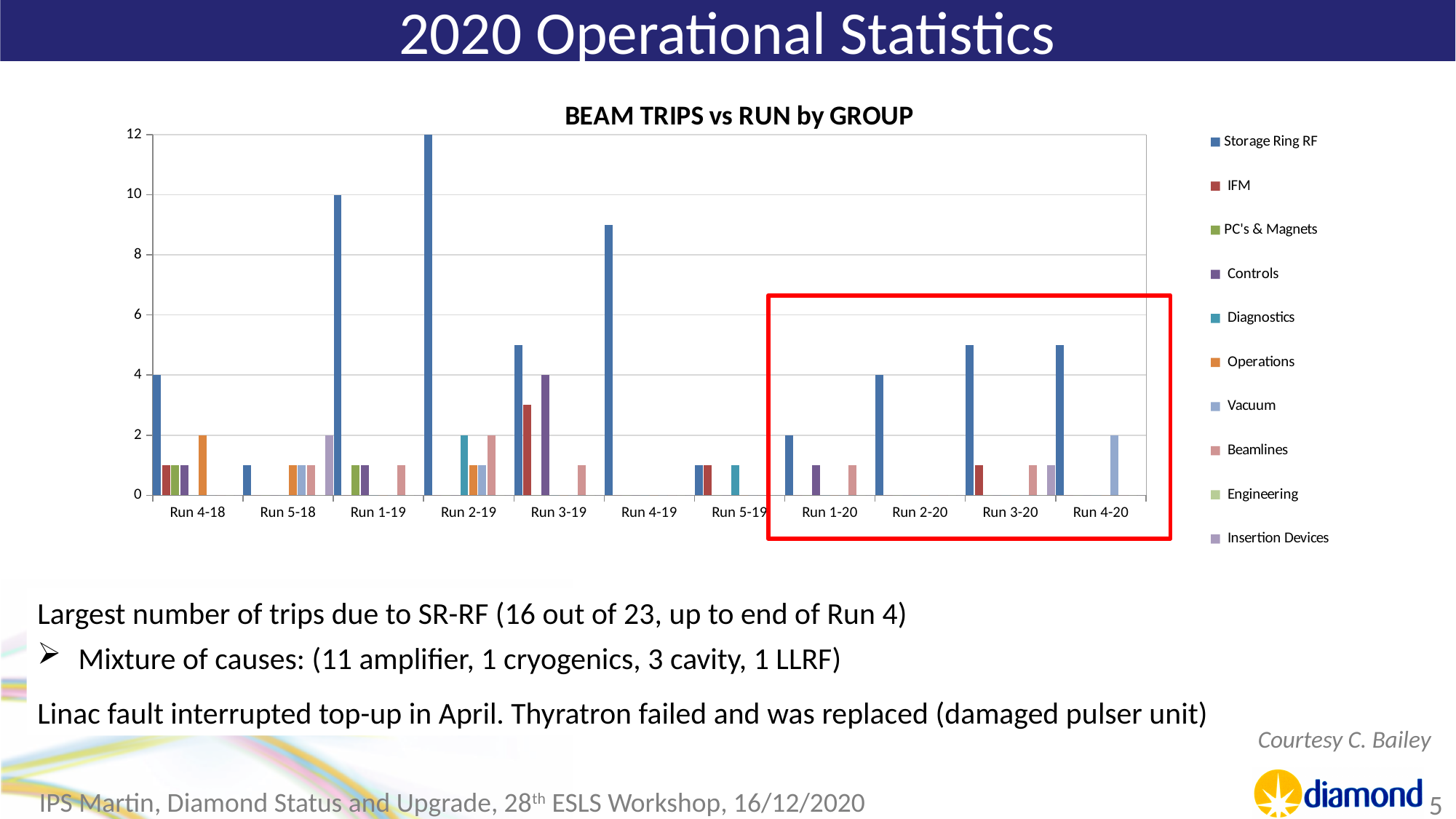
What is the difference between the Storage Ring RF values for Run 2-19 and Run 1-19? 2 How many series does the legend list? 10 What is the Storage Ring RF value for Run 1-19? 10 What is the title of the chart? BEAM TRIPS vs RUN by GROUP What is the Storage Ring RF value for Run 2-19? 12 Is the Storage Ring RF value for Run 4-19 greater or less than 8? greater What kind of chart is shown on the slide? bar chart What is the Storage Ring RF value for Run 1-20? 2 What is the Storage Ring RF value for Run 2-20? 4 In which run is the Storage Ring RF value highest? Run 2-19 Which is larger, the Storage Ring RF value for Run 1-19 or for Run 4-18? Run 1-19 How many runs are shown along the x axis? 11